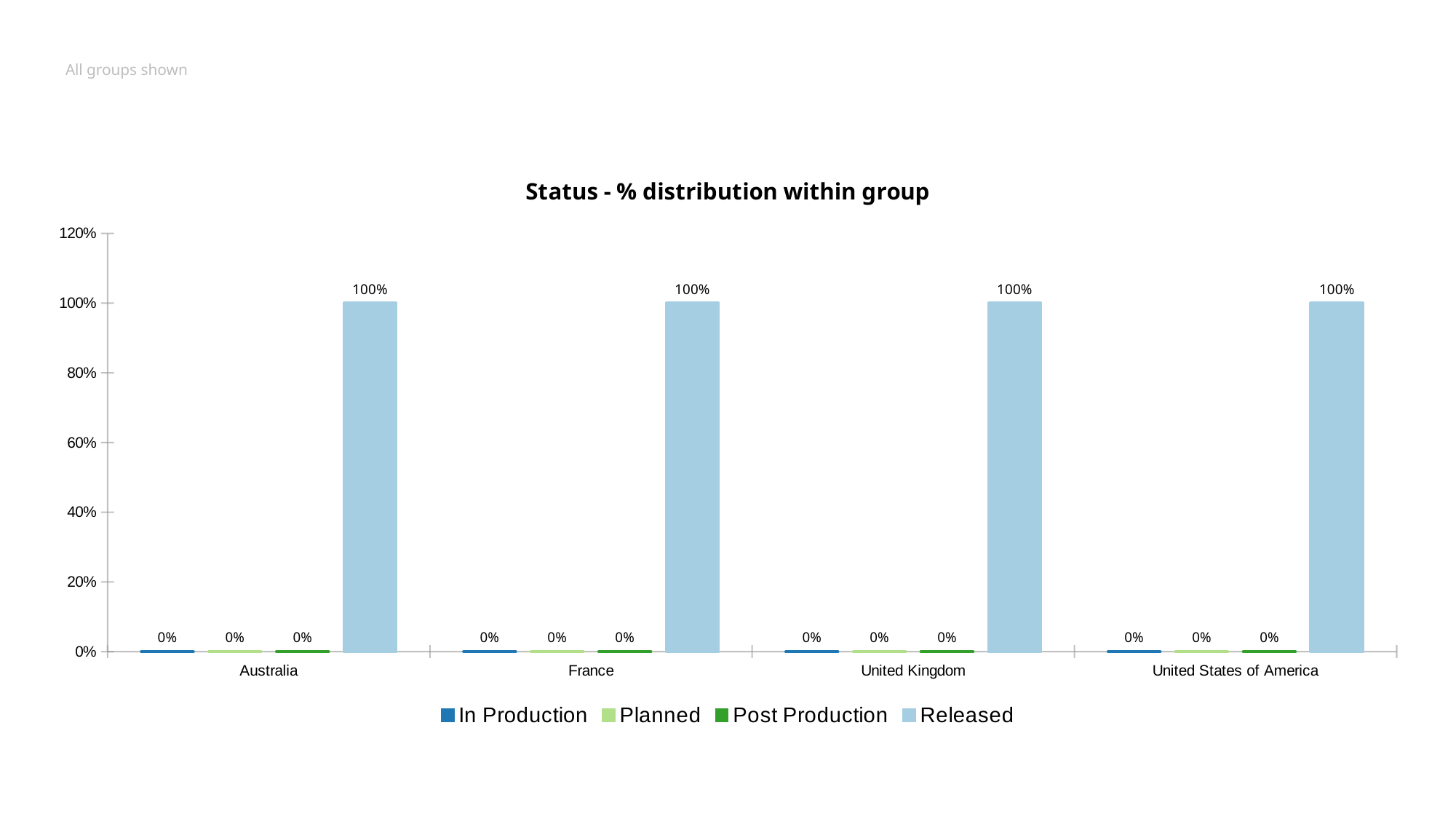
Which is larger for Australia: Released or In Production? Released What is the difference between Released and Planned for the United Kingdom? 100% What is the title of the chart? Status - % distribution within group What is the value for Planned in the United Kingdom? 0% What kind of chart is shown? Bar chart What is the value for Released in Australia? 100% Which series is shown in light blue in the legend? Released How many categories are shown on the x axis? 4 What is the value for Post Production in the United States of America? 0% What is the value for In Production in France? 0% How many series does the legend list? 4 Which series has the highest value for France? Released